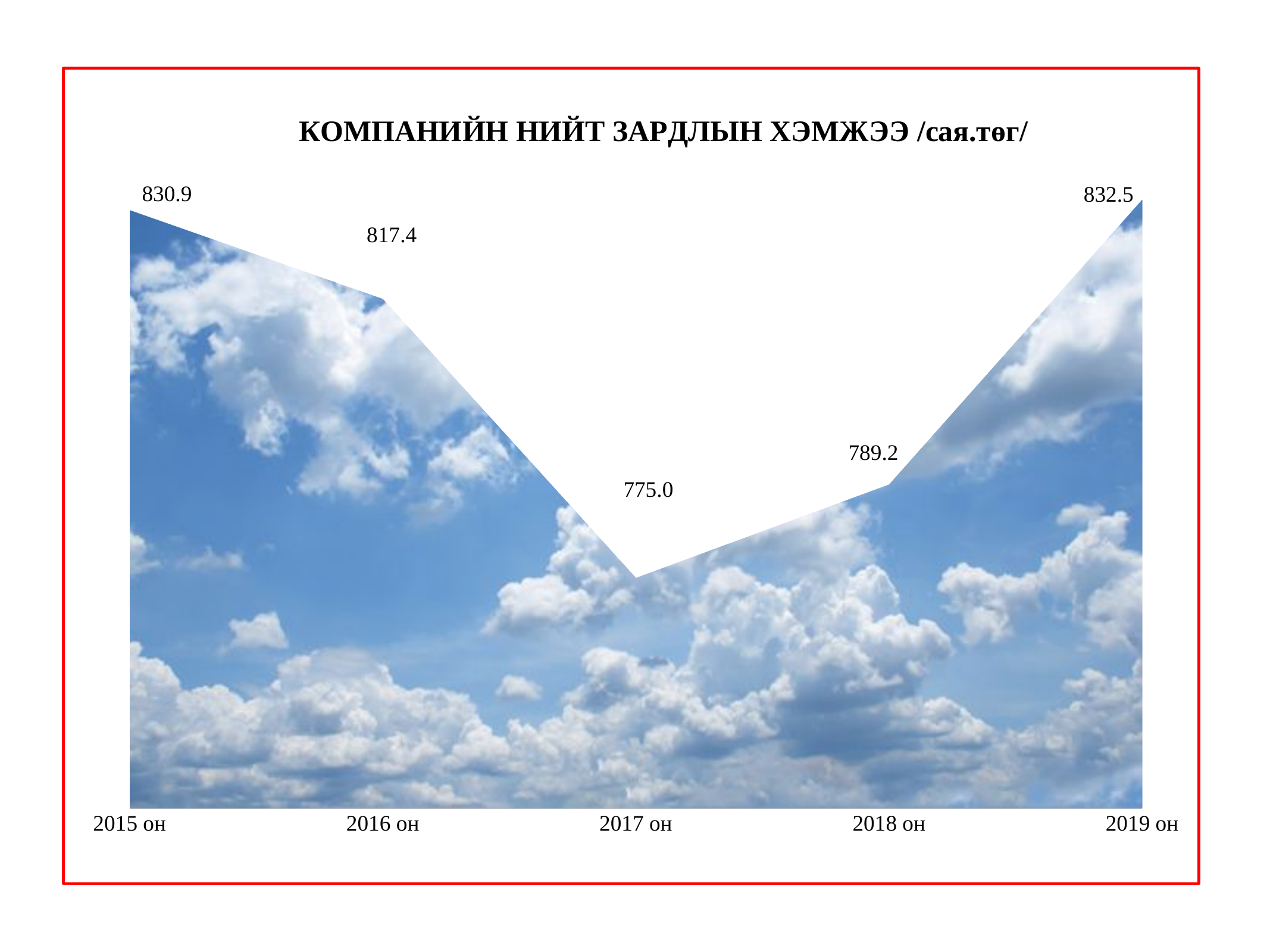
What is the value for 2015 он? 830.9 What is the value for 2018 он? 789.2 What is the difference between the values for 2015 он and 2016 он? 13.5 What is the difference between the values for 2018 он and 2017 он? 14.2 What is the value for 2017 он? 775.0 Which is larger, the value for 2016 он or the value for 2018 он? 2016 он How many years are plotted on the chart? 5 What is the value for 2019 он? 832.5 What kind of chart is this? Area chart Which year has the highest value? 2019 он Do the values rise or fall from 2017 он to 2019 он? Rise Which year has the lowest value? 2017 он